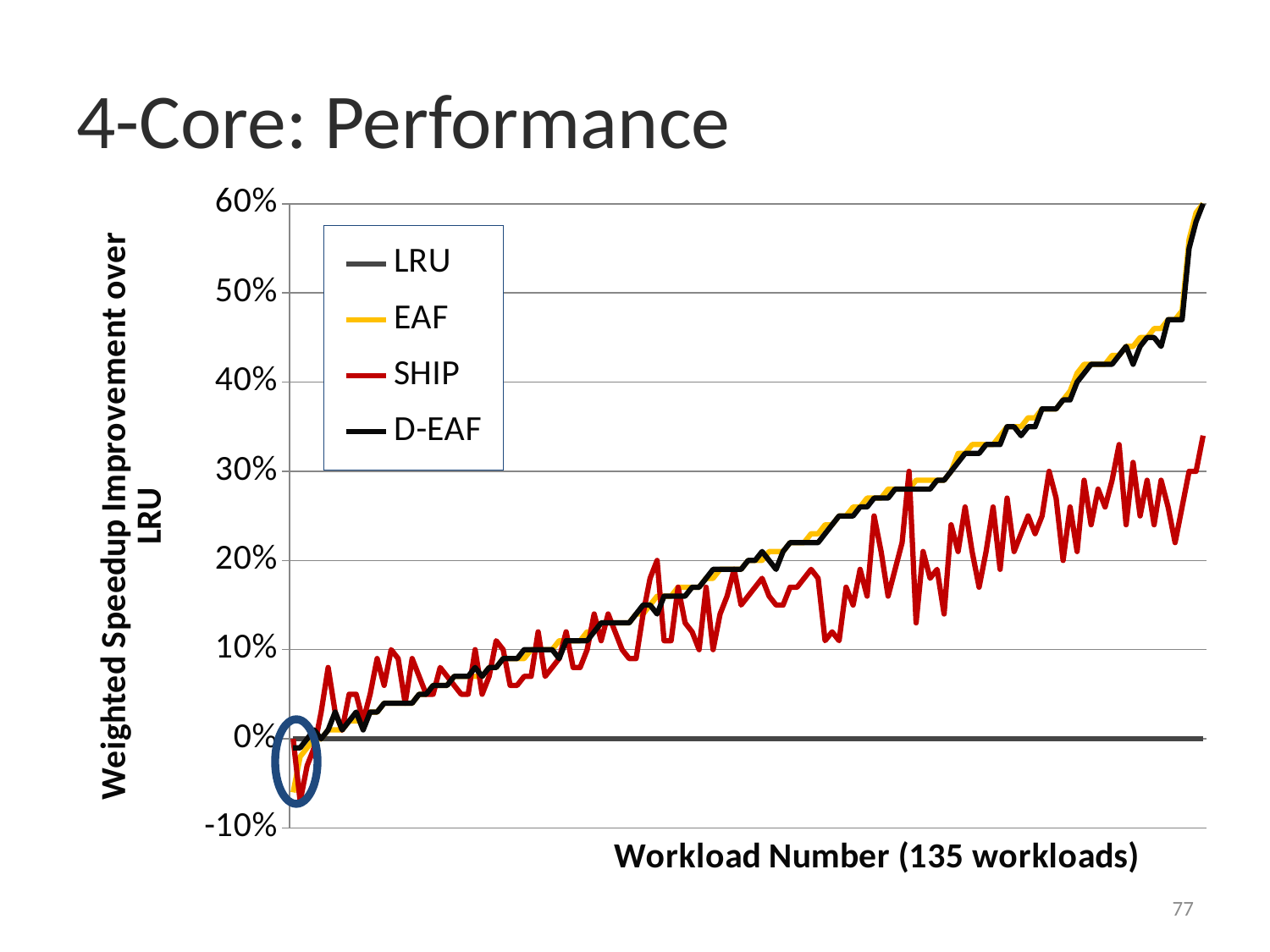
At the rightmost workload, which series is higher: SHIP or D-EAF? D-EAF What kind of chart is shown on the slide? line chart Which series stays flat at 0% across all workloads? LRU Which series has the lowest value at the rightmost workload? LRU Is the highest value reached by the D-EAF series greater or less than 50%? greater Do the D-EAF values rise or fall as the workload number increases along the x axis? rise Is the lowest value of the SHIP series greater or less than 0%? less How many series does the legend list? 4 How many workloads does the x-axis label say are plotted? 135 What is the title of the slide? 4-Core: Performance What is the y-axis label of the chart? Weighted Speedup Improvement over LRU Is the highest value reached by the SHIP series greater or less than 40%? less